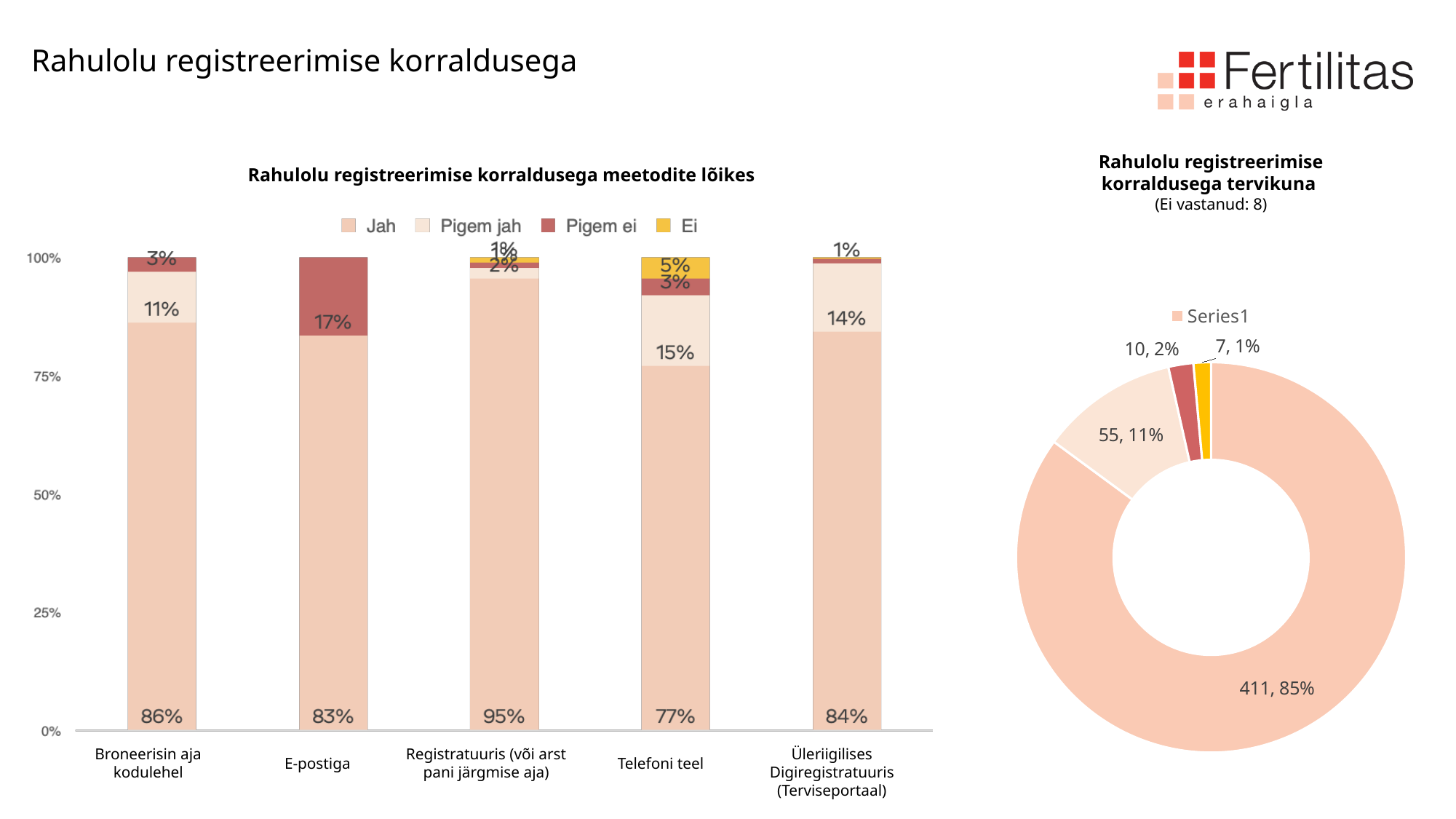
How many categories are shown on the x axis of the left chart? 5 What kind of chart is the right chart titled "Rahulolu registreerimise korraldusega tervikuna"? Donut (pie) chart In the left chart, which category has the highest "Jah" value? Registratuuris (või arst pani järgmise aja) In the left chart, which category has the lowest "Jah" value? Telefoni teel What kind of chart is the left chart titled "Rahulolu registreerimise korraldusega meetodite lõikes"? Stacked bar chart In the left chart, what is the "Pigem ei" value for "E-postiga"? 17% In the left chart, what is the "Ei" value for "Telefoni teel"? 5% How many series does the legend of the left chart list? 4 In the left chart, what is the difference between the "Jah" value for "Registratuuris (või arst pani järgmise aja)" and for "Telefoni teel"? 18 percentage points In the right chart, what is the count and share of the largest slice? 411, 85% In the right chart, how many slices does the donut have? 4 In the left chart, what is the "Jah" value for "Telefoni teel"? 77%